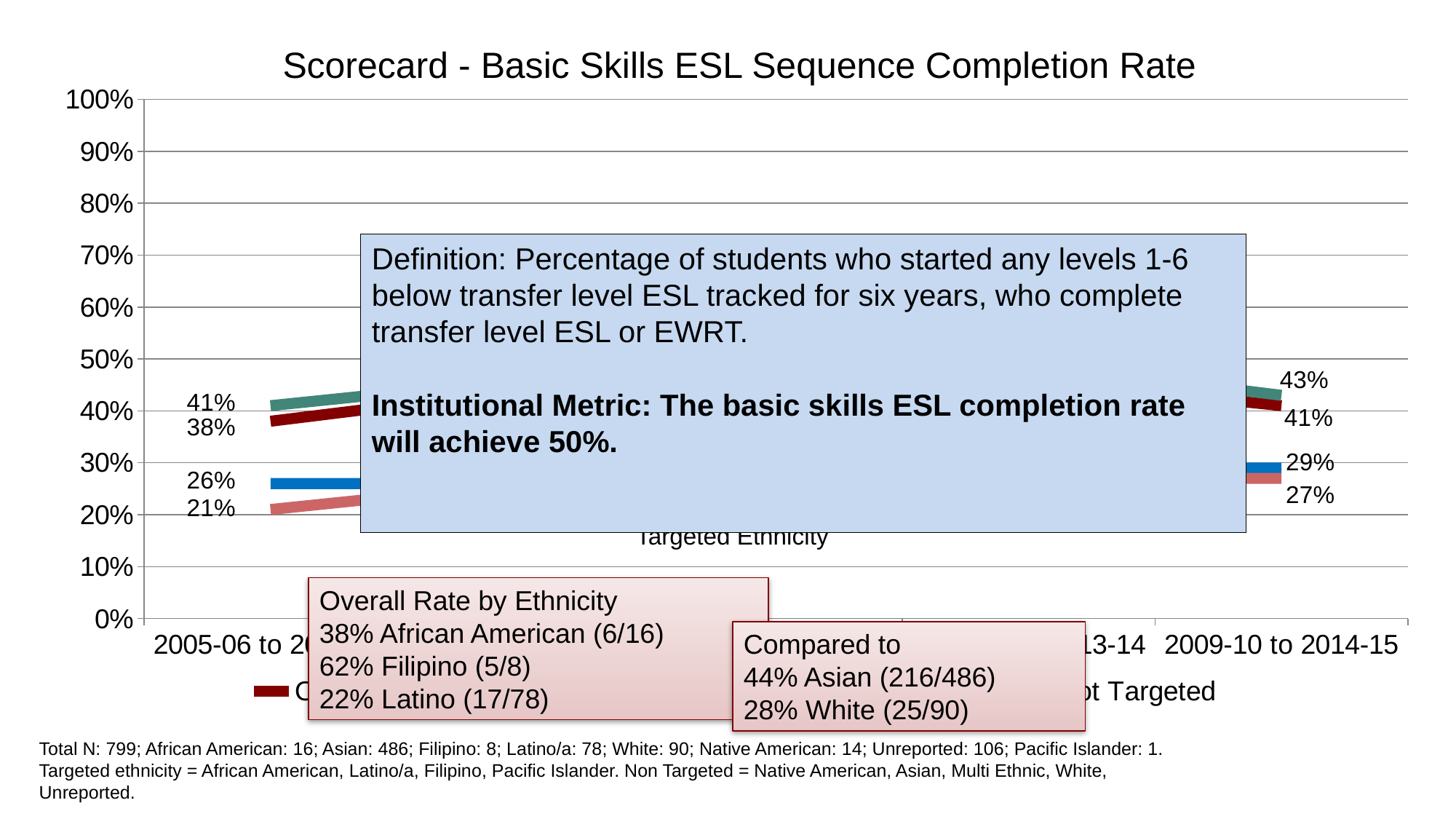
What is the difference between the highest and lowest data labels at the 2009-10 to 2014-15 cohort? 16 percentage points What kind of chart is shown on the slide? line chart What is the lowest data label shown for the 2009-10 to 2014-15 cohort? 27% What is the difference between the two highest data labels at the 2009-10 to 2014-15 cohort (43% and 41%)? 2 percentage points What is the highest data label shown for the 2009-10 to 2014-15 cohort? 43% What is the lowest data label shown at the first cohort on the left of the chart? 21% Is the highest line's value at 2009-10 to 2014-15 greater or less than 50%? less What is the highest data label shown at the first cohort on the left of the chart? 41% What is the title of the chart? Scorecard - Basic Skills ESL Sequence Completion Rate Does the top (green) line rise or fall from the first cohort to the 2009-10 to 2014-15 cohort? rise At the 2009-10 to 2014-15 cohort, which is larger: the green line's value or the blue line's value? the green line's value What is the maximum value shown on the y axis? 100%